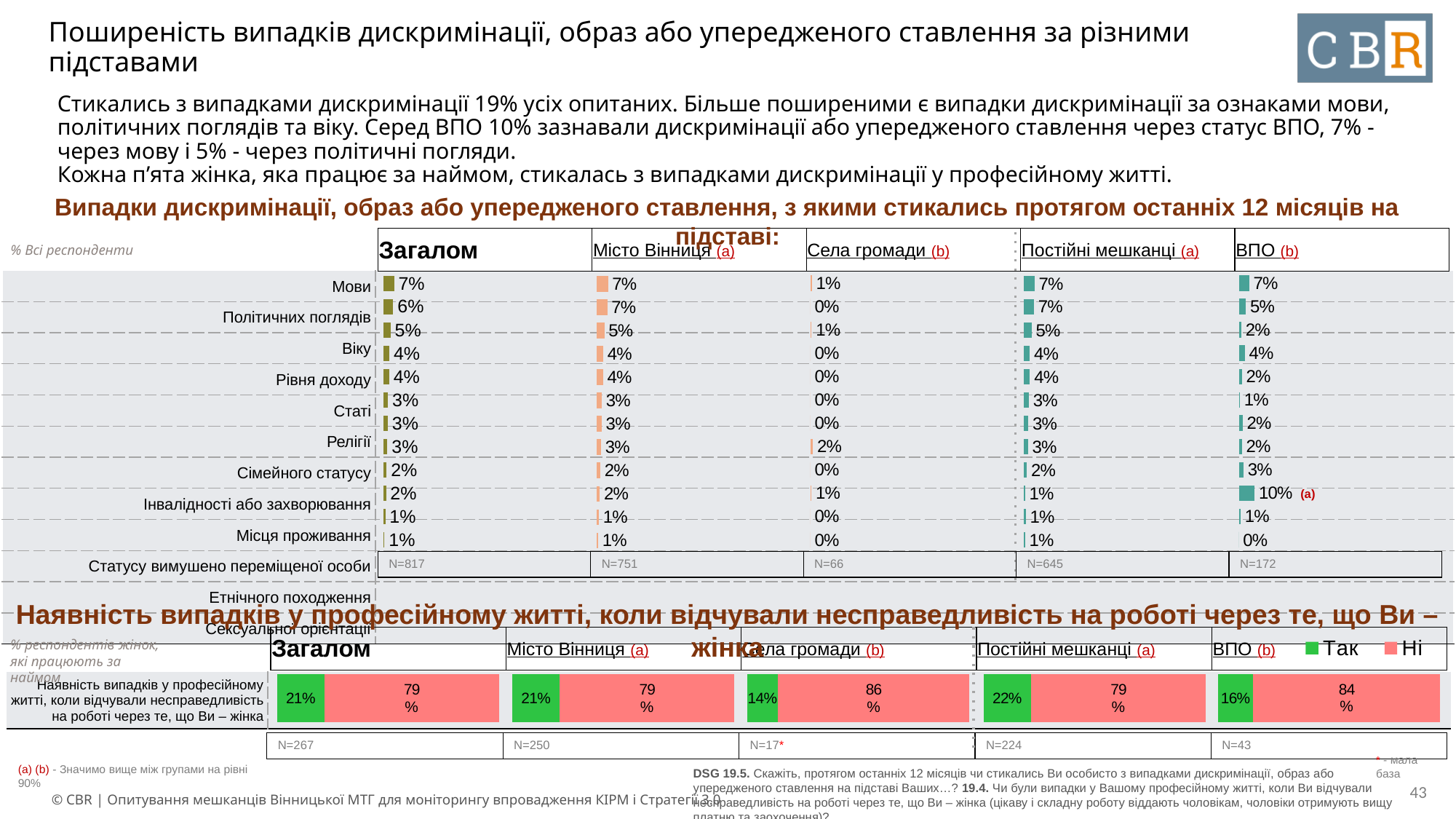
In the bottom chart, which group has the lowest "Так" share? Села громади In the bottom chart, what is the difference between the "Так" shares of Постійні мешканці and ВПО? 6 percentage points In the bottom chart, which colour represents "Так"? Green In the top chart, which is larger for Мови: the Місто Вінниця value or the Села громади value? Місто Вінниця What type of chart is the bottom chart on the slide? Stacked bar chart In the bottom chart, what is the "Ні" share for Села громади? 86% In the bottom chart, how many series does the legend list? 2 In the top chart on discrimination in the last 12 months, what is the Загалом value for Мови? 7% In the top chart, what is the value for Мови among Села громади? 1% In the top chart, what is the highest value shown in the ВПО column? 10% In the bottom chart about unfairness at work because of being a woman, what percentage of women overall (Загалом) answered "Так"? 21% In the bottom chart, which group has the highest "Так" share? Постійні мешканці